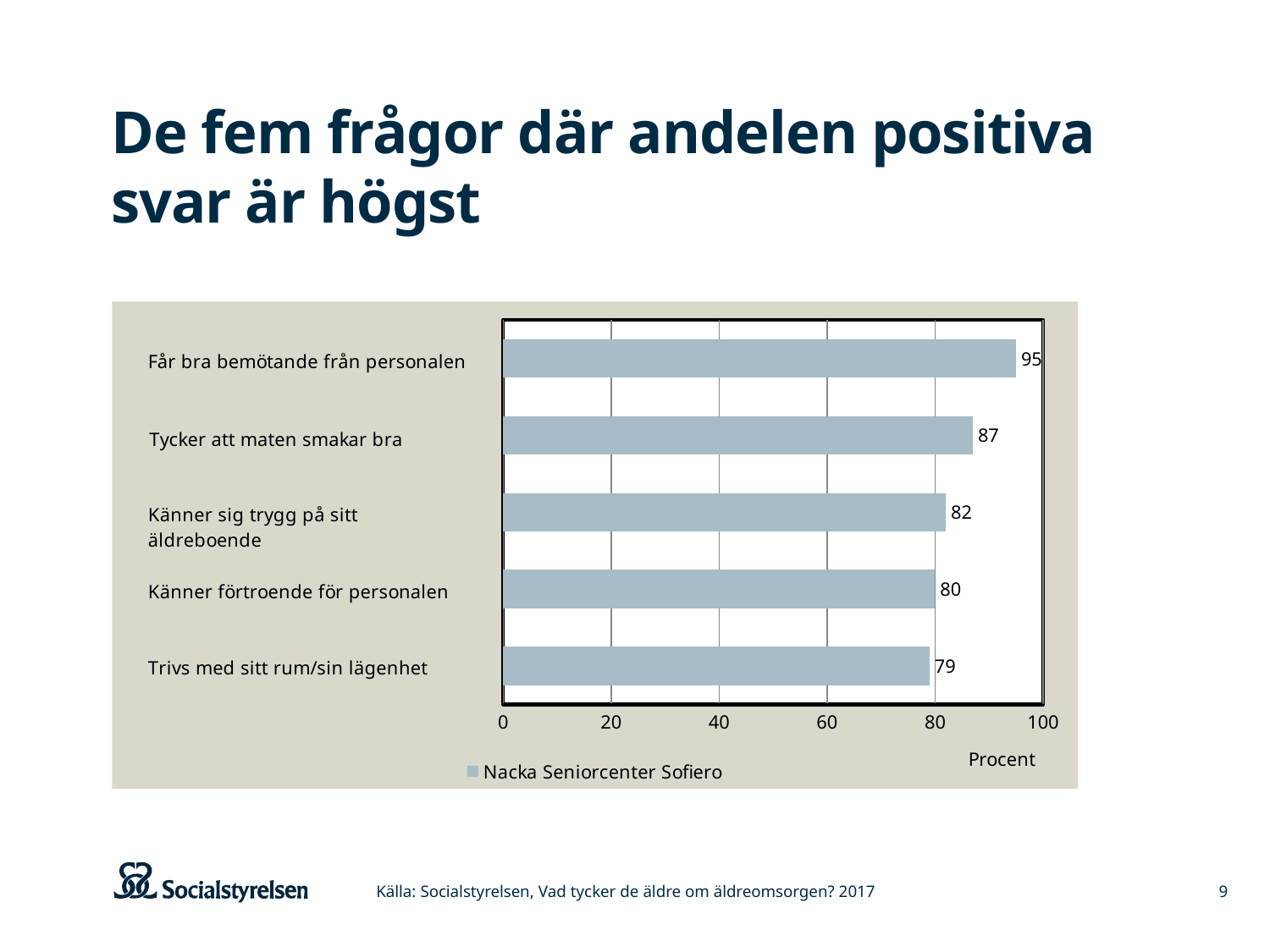
How many categories are shown in the chart? 5 What is the value for "Får bra bemötande från personalen"? 95 What is the value for "Trivs med sitt rum/sin lägenhet"? 79 Is the value for "Trivs med sitt rum/sin lägenhet" greater or less than 80? less Which is larger: the value for "Känner förtroende för personalen" or "Känner sig trygg på sitt äldreboende"? Känner sig trygg på sitt äldreboende Which category has the lowest value? Trivs med sitt rum/sin lägenhet What series name does the legend show? Nacka Seniorcenter Sofiero What is the difference between the values for "Får bra bemötande från personalen" and "Tycker att maten smakar bra"? 8 Which category has the highest value? Får bra bemötande från personalen What is the value for "Tycker att maten smakar bra"? 87 What is the value for "Känner sig trygg på sitt äldreboende"? 82 What kind of chart is shown on the slide? bar chart